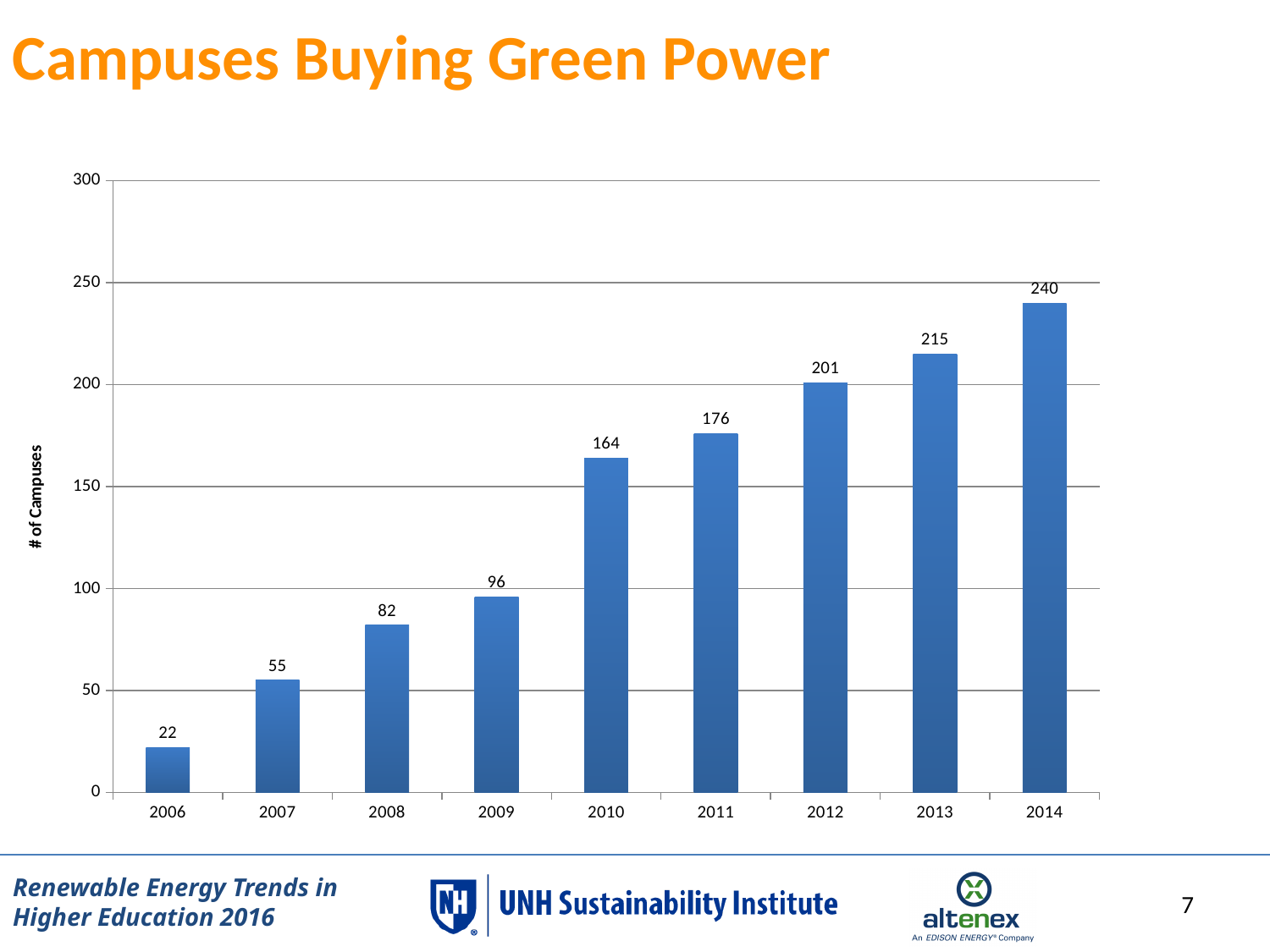
What is the difference in the number of campuses between 2014 and 2013? 25 Which year has more campuses buying green power, 2008 or 2011? 2011 What kind of chart is shown on the slide? bar chart What is the number of campuses buying green power in 2006? 22 What is the number of campuses buying green power in 2013? 215 Do the values rise or fall from 2006 to 2014? rise Which year has the lowest number of campuses buying green power? 2006 What is the difference in the number of campuses between 2010 and 2009? 68 What is the number of campuses buying green power in 2010? 164 Is the value for 2012 greater or less than 150? greater How many years are shown on the x axis of the chart? 9 Which year has the highest number of campuses buying green power? 2014